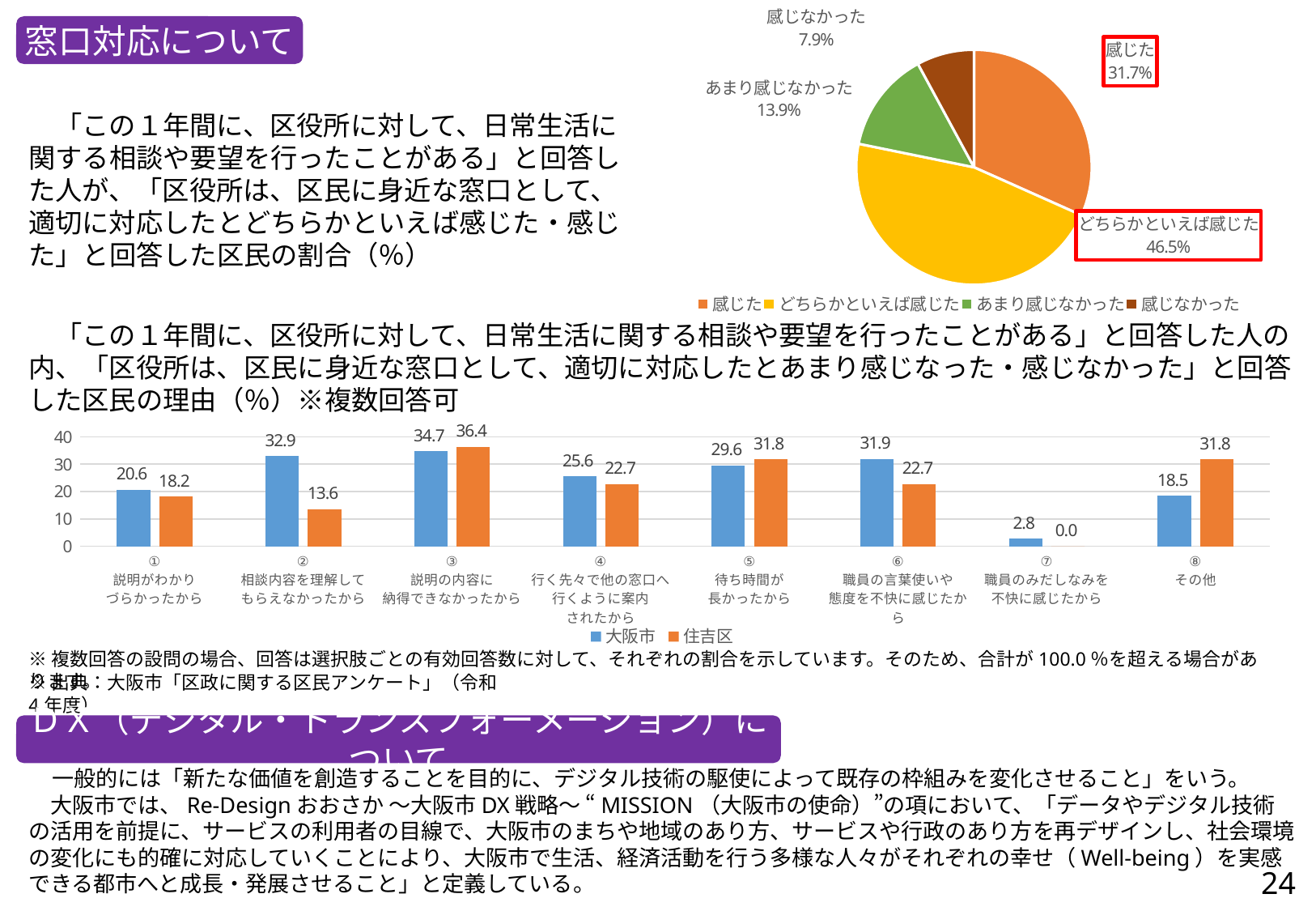
In the bar chart at the bottom, what is the value for 大阪市 in category ② 相談内容を理解してもらえなかったから? 32.9 In the pie chart at the top right, what share of respondents answered 「感じなかった」? 7.9% In the bar chart at the bottom, which is larger in category ⑤ 待ち時間が長かったから, 大阪市 or 住吉区? 住吉区 In the pie chart at the top right, how many slices are there? 4 In the bar chart at the bottom, what is the value for 住吉区 in category ⑧ その他? 31.8 In the pie chart at the top right, what share of respondents answered 「どちらかといえば感じた」? 46.5% In the bar chart at the bottom, how many series does the legend list? 2 In the bar chart at the bottom, what is the difference between 大阪市 and 住吉区 in category ② 相談内容を理解してもらえなかったから? 19.3 In the bar chart at the bottom, which category has the highest value for 住吉区? ③ 説明の内容に納得できなかったから In the pie chart at the top right, what is the combined share of 「感じた」 and 「どちらかといえば感じた」? 78.2% In the bar chart at the bottom, which category has the lowest value for 大阪市? ⑦ 職員のみだしなみを不快に感じたから In the pie chart at the top right, which response has the largest slice? どちらかといえば感じた